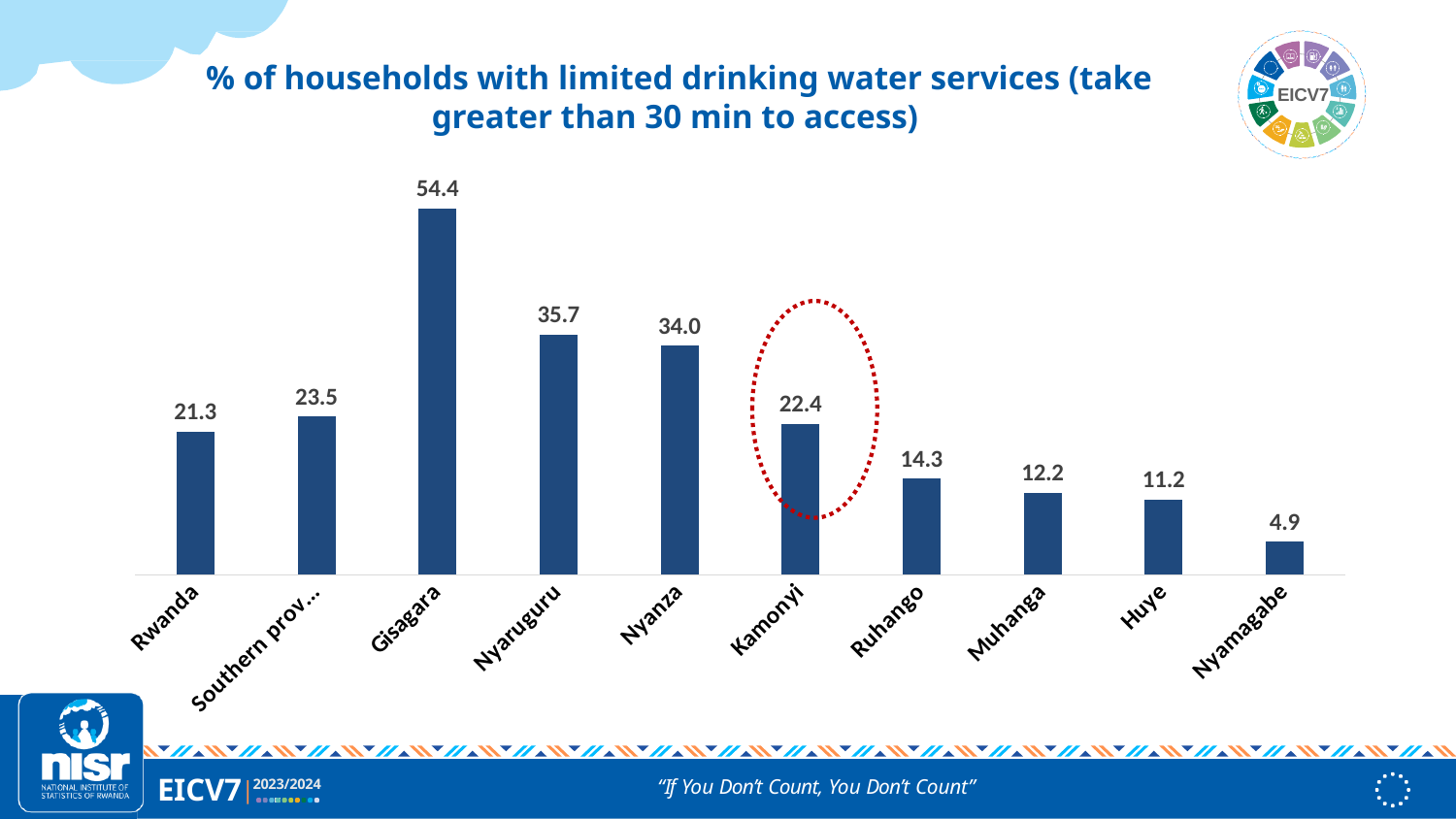
What is the value for Kamonyi? 22.4 What is the difference between the values for Gisagara and Nyaruguru? 18.7 What is the value for Rwanda? 21.3 What is the title of the chart? % of households with limited drinking water services (take greater than 30 min to access) Which is larger, the value for Nyanza or the value for Ruhango? Nyanza What kind of chart is shown on the slide? Bar chart What is the difference between the values for Kamonyi and Huye? 11.2 Which category has the lowest value? Nyamagabe What is the value for Gisagara? 54.4 How many categories are shown on the x axis? 10 Which category has the highest value? Gisagara Which category is highlighted with a red dotted circle? Kamonyi